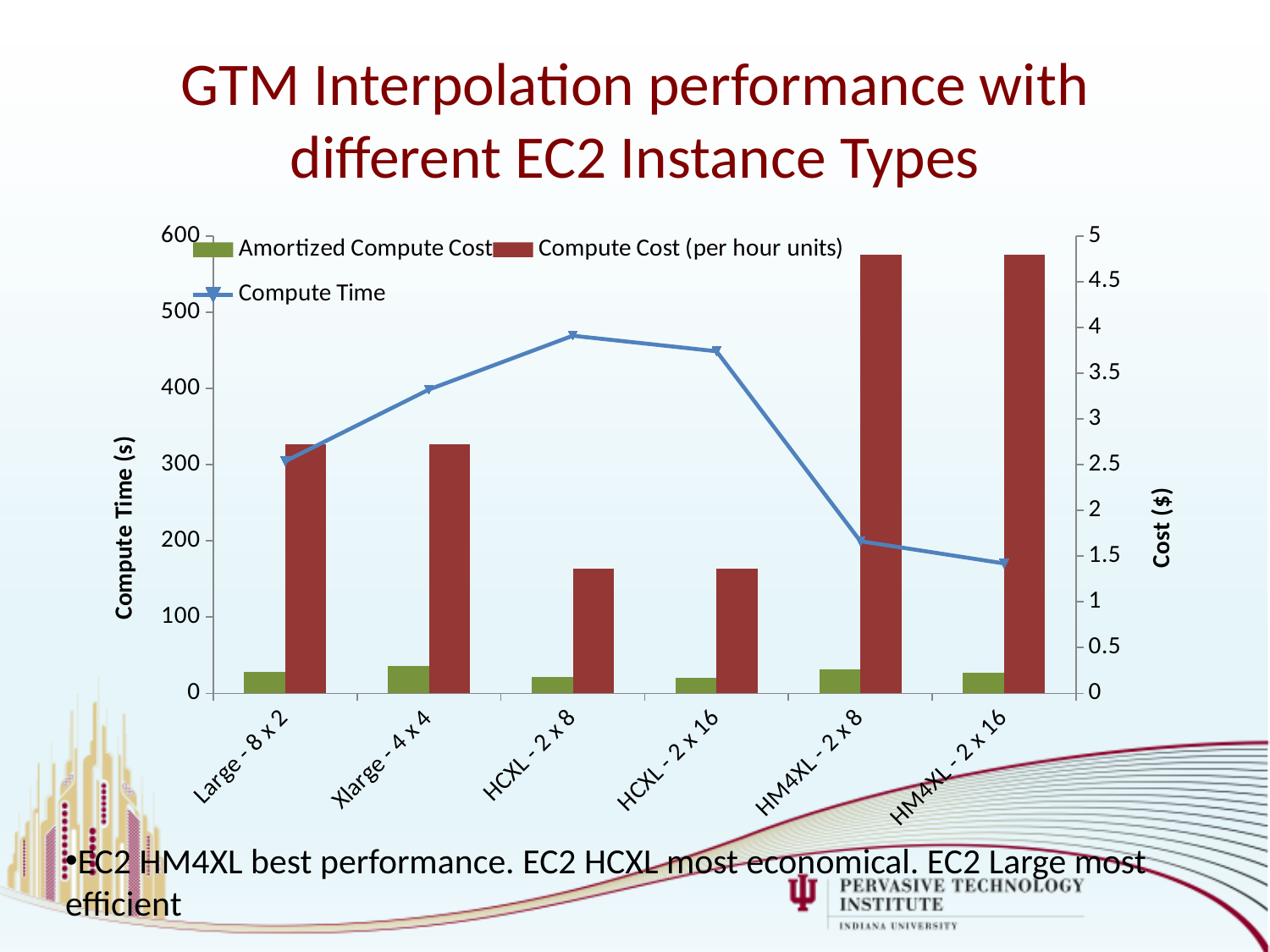
What is the label of the right-hand vertical axis of the chart? Cost ($) Which instance type has the lowest Compute Time? HM4XL - 2 x 16 Is the Compute Time for HM4XL - 2 x 16 greater or less than 200? less Does the Compute Time rise or fall from HCXL - 2 x 16 to HM4XL - 2 x 16? fall Which instance type has the highest Compute Time? HCXL - 2 x 8 Which is larger, the Compute Cost (per hour units) for HM4XL - 2 x 8 or for HCXL - 2 x 8? HM4XL - 2 x 8 How many series does the chart's legend list? 3 How many EC2 instance type categories are shown on the x axis of the chart? 6 Is the Compute Cost (per hour units) for HM4XL - 2 x 8 greater or less than 4? greater Is the Compute Time for HCXL - 2 x 8 greater or less than 400? greater What kind of chart is shown on the slide? Combination bar and line chart